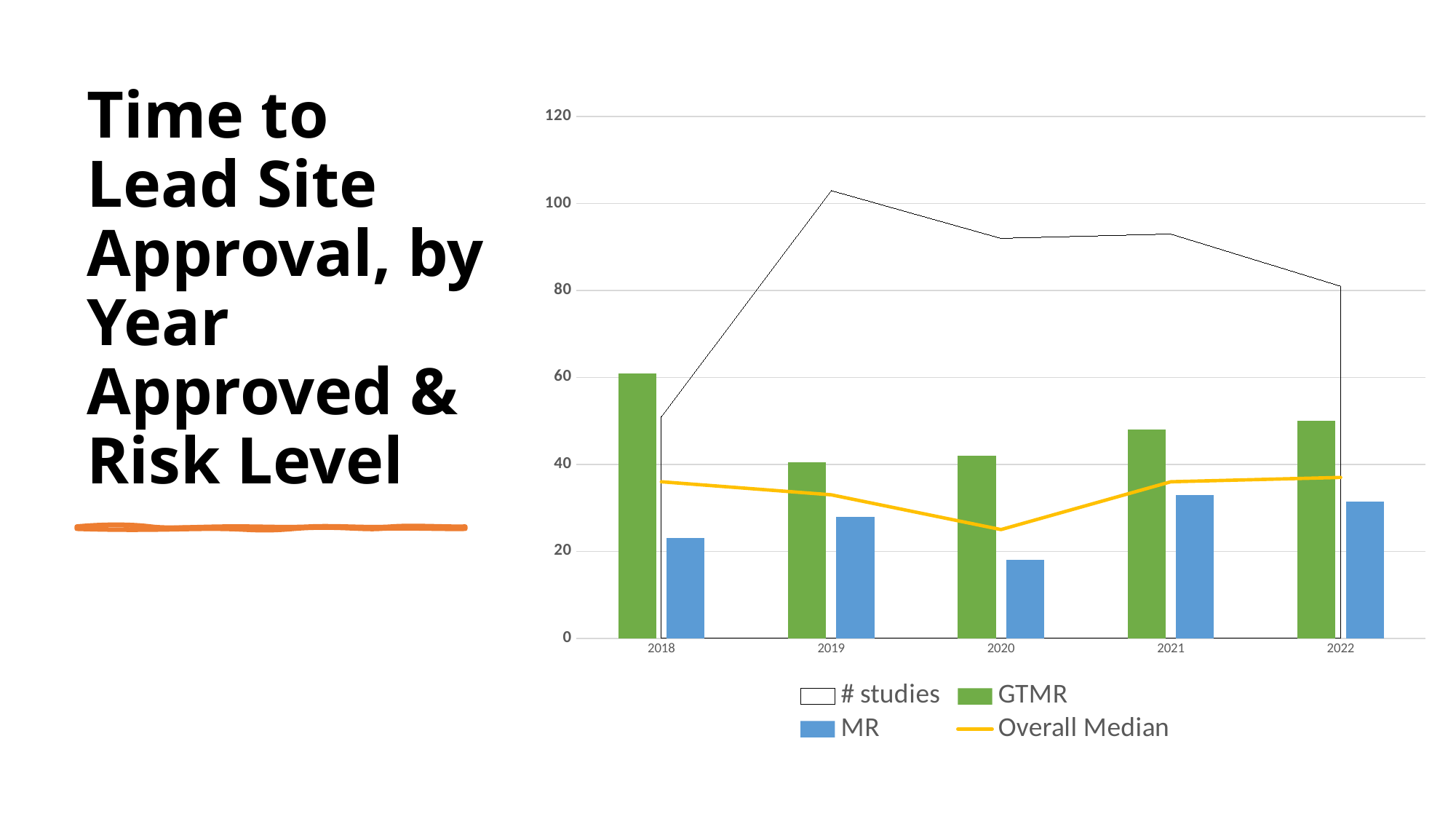
In which year is the # studies line at its lowest point? 2018 What colour is the Overall Median line? Yellow Is the # studies value for 2022 greater or less than 100? less Is the GTMR value for 2018 greater or less than 40? greater How many years are shown on the x axis? 5 In 2018, which is larger, the GTMR bar or the MR bar? GTMR In which year is the MR bar lowest? 2020 How many series does the legend list? 4 Is the MR value for 2020 greater or less than 20? less In which year is the GTMR bar highest? 2018 Does the # studies line rise or fall from 2019 to 2022? fall In which year does the # studies line reach its highest point? 2019